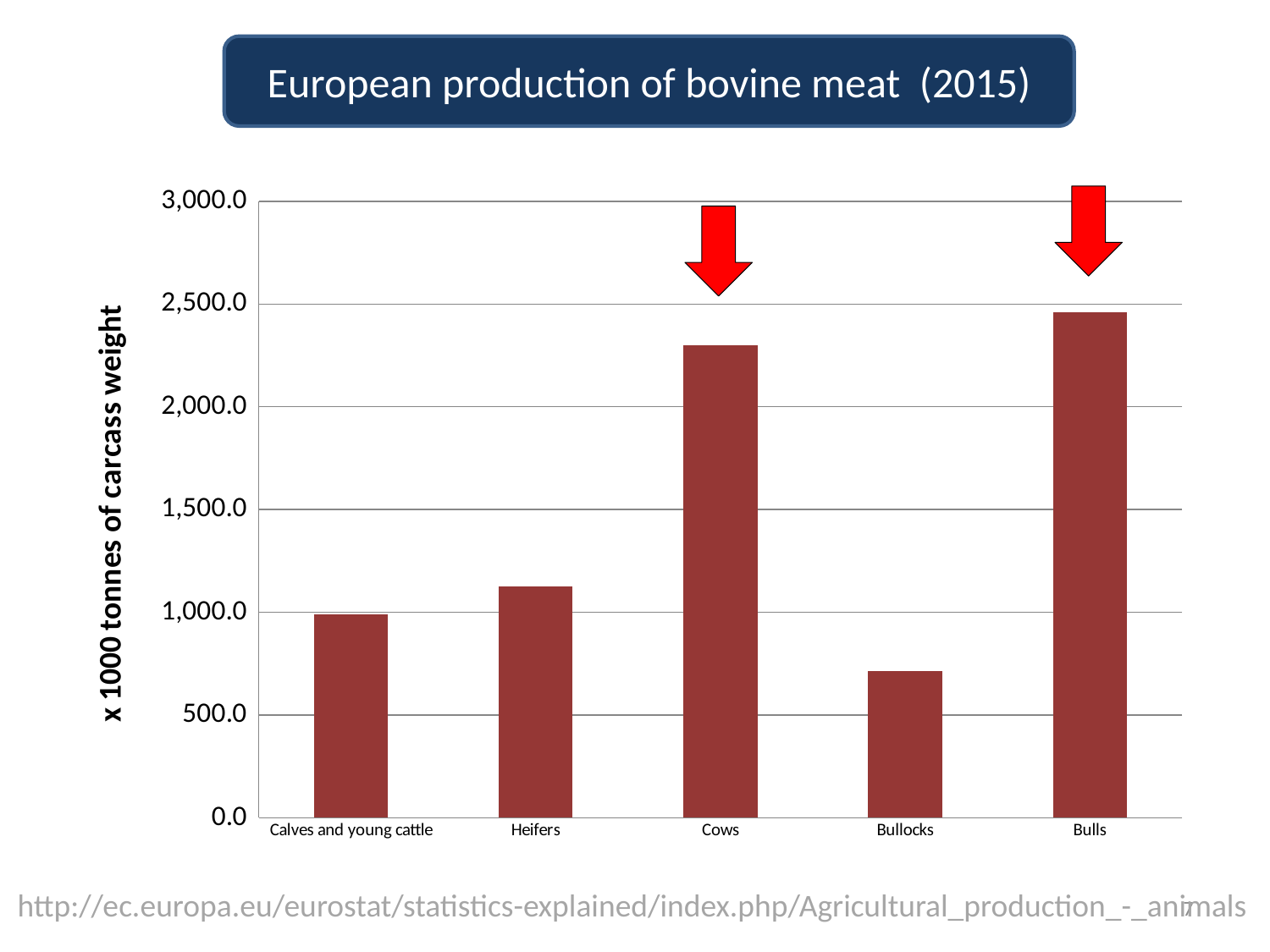
How many categories are shown on the x axis of the chart? 5 Is the value for Heifers greater or less than 1,000.0? greater What is the label of the y axis of the chart? x 1000 tonnes of carcass weight Which category has the highest production of bovine meat? Bulls Is the value for Bullocks greater or less than 1,000.0? less What kind of chart is shown on the slide? bar chart Which category has the lowest production of bovine meat? Bullocks Is the value for Bulls greater or less than 2,000.0? greater Which is larger, the value for Heifers or the value for Calves and young cattle? Heifers Which is larger, the value for Cows or the value for Bulls? Bulls